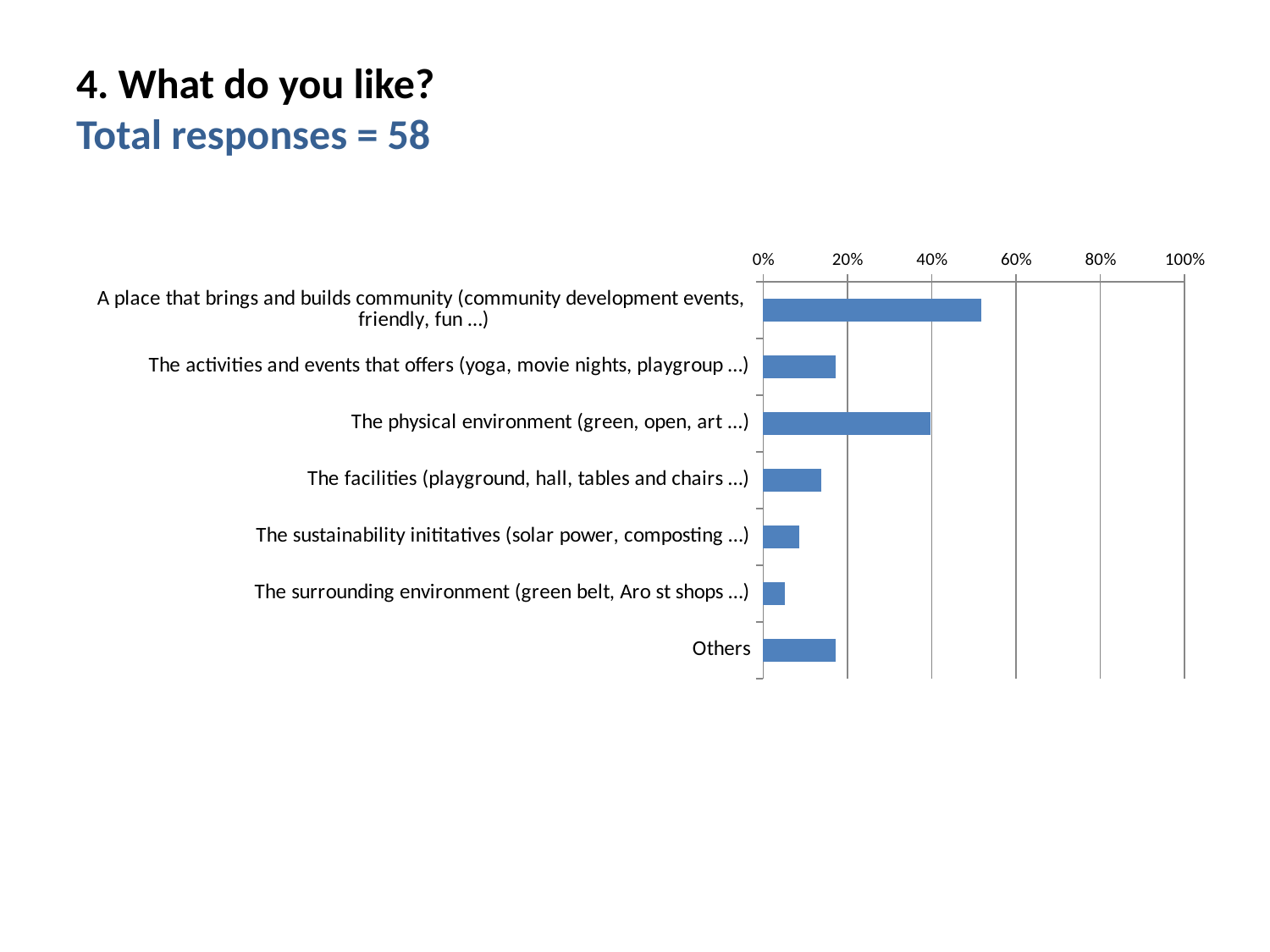
Is the value for 'The sustainability inititatives' greater or less than 20%? less Is the value for 'The activities and events that offers' greater or less than 20%? less Which category has the lowest value in the chart? The surrounding environment (green belt, Aro st shops …) How many categories are plotted in the chart? 7 Is the value for 'A place that brings and builds community' greater or less than 40%? greater Which is larger: the value for 'The physical environment' or the value for 'The activities and events that offers'? The physical environment Which is larger: the value for 'The facilities' or the value for 'The surrounding environment'? The facilities Which category has the highest value in the chart? A place that brings and builds community (community development events, friendly, fun …) How many total responses does the slide state? 58 What kind of chart is shown on the slide? bar chart What is the title of the slide above the chart? 4. What do you like?